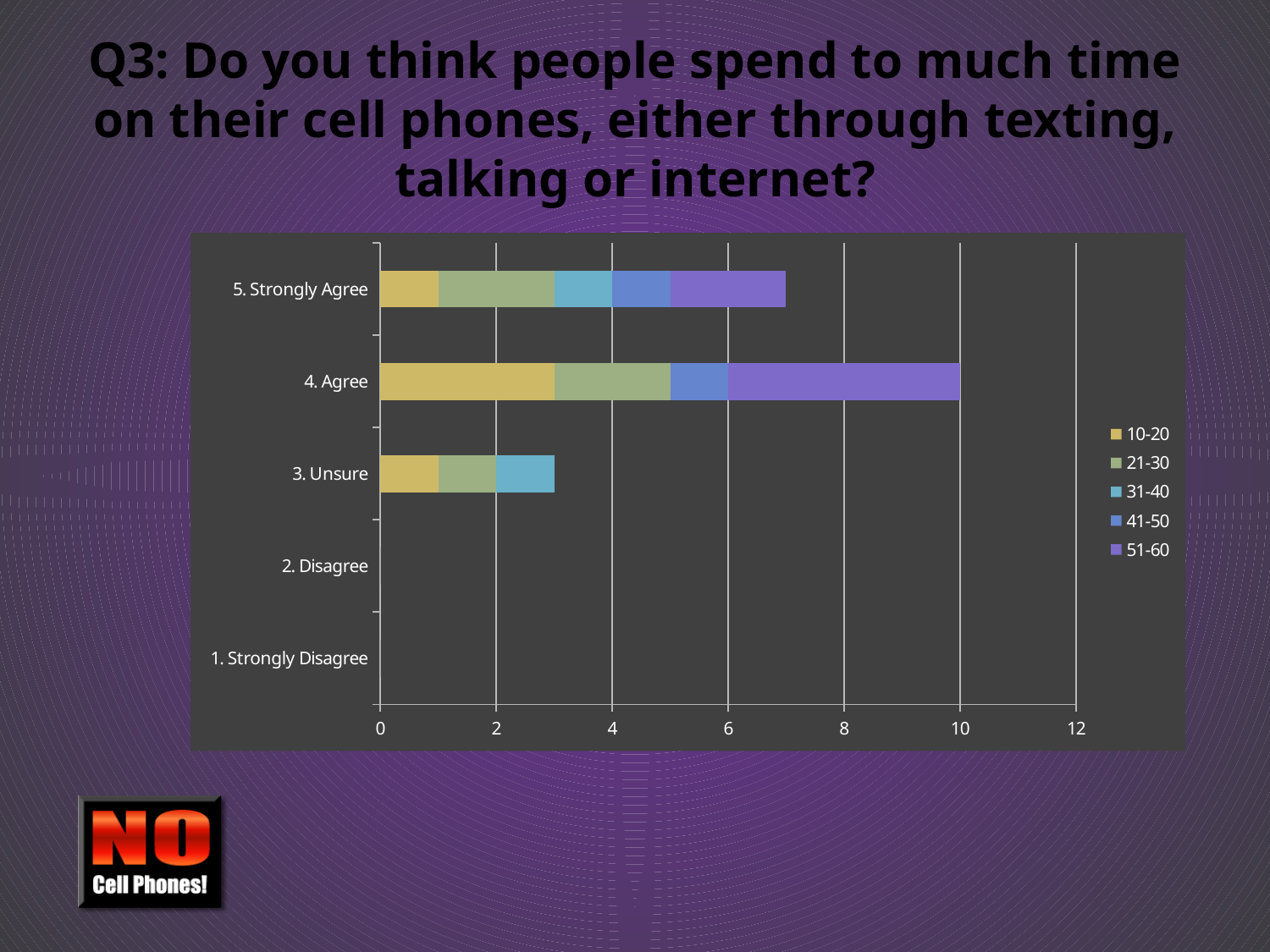
Which has the larger total, 5. Strongly Agree or 3. Unsure? 5. Strongly Agree How many response categories are listed on the vertical axis? 5 Which response categories have no bar at all? 2. Disagree and 1. Strongly Disagree Is the total for 3. Unsure greater or less than 4? less What kind of chart is shown on the slide? stacked bar chart Which age group does the first legend entry represent? 10-20 Which response category has the longest bar? 4. Agree How many series does the legend list? 5 What is the highest value shown on the horizontal axis? 12 Is the total for 5. Strongly Agree greater or less than 8? less What is the total length of the stacked bar for 4. Agree? 10 Is the total for 5. Strongly Agree greater or less than 6? greater